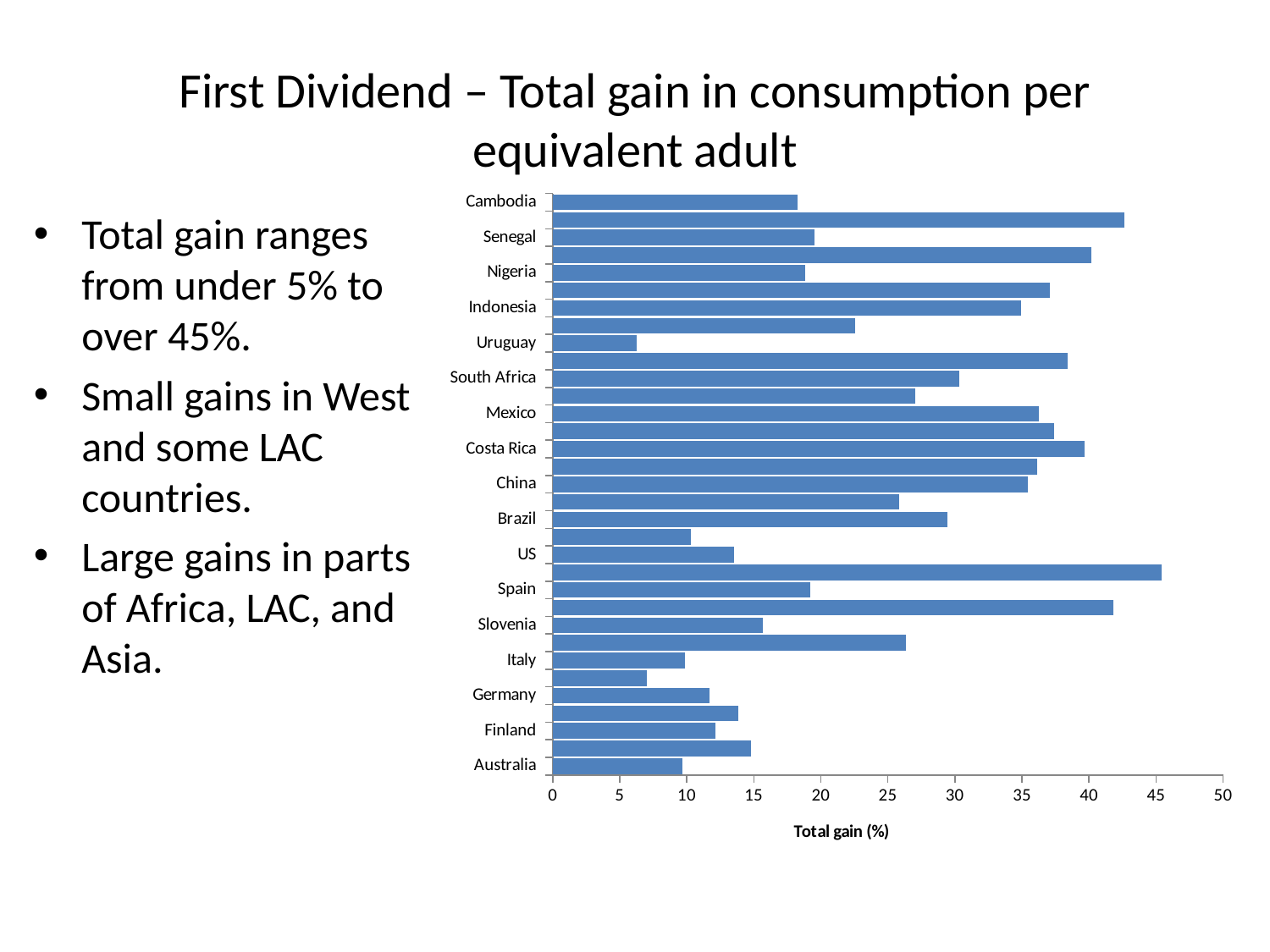
Is the value for Costa Rica greater or less than 35? greater What kind of chart is shown on the slide? bar chart What is the title of the horizontal axis of the chart? Total gain (%) Is the value for Uruguay greater or less than 10? less Is the value for Brazil greater or less than 25? greater Which has the larger value, Indonesia or US? Indonesia Among the countries labeled on the axis, which has the lowest value? Uruguay Which has the larger value, Costa Rica or Uruguay? Costa Rica